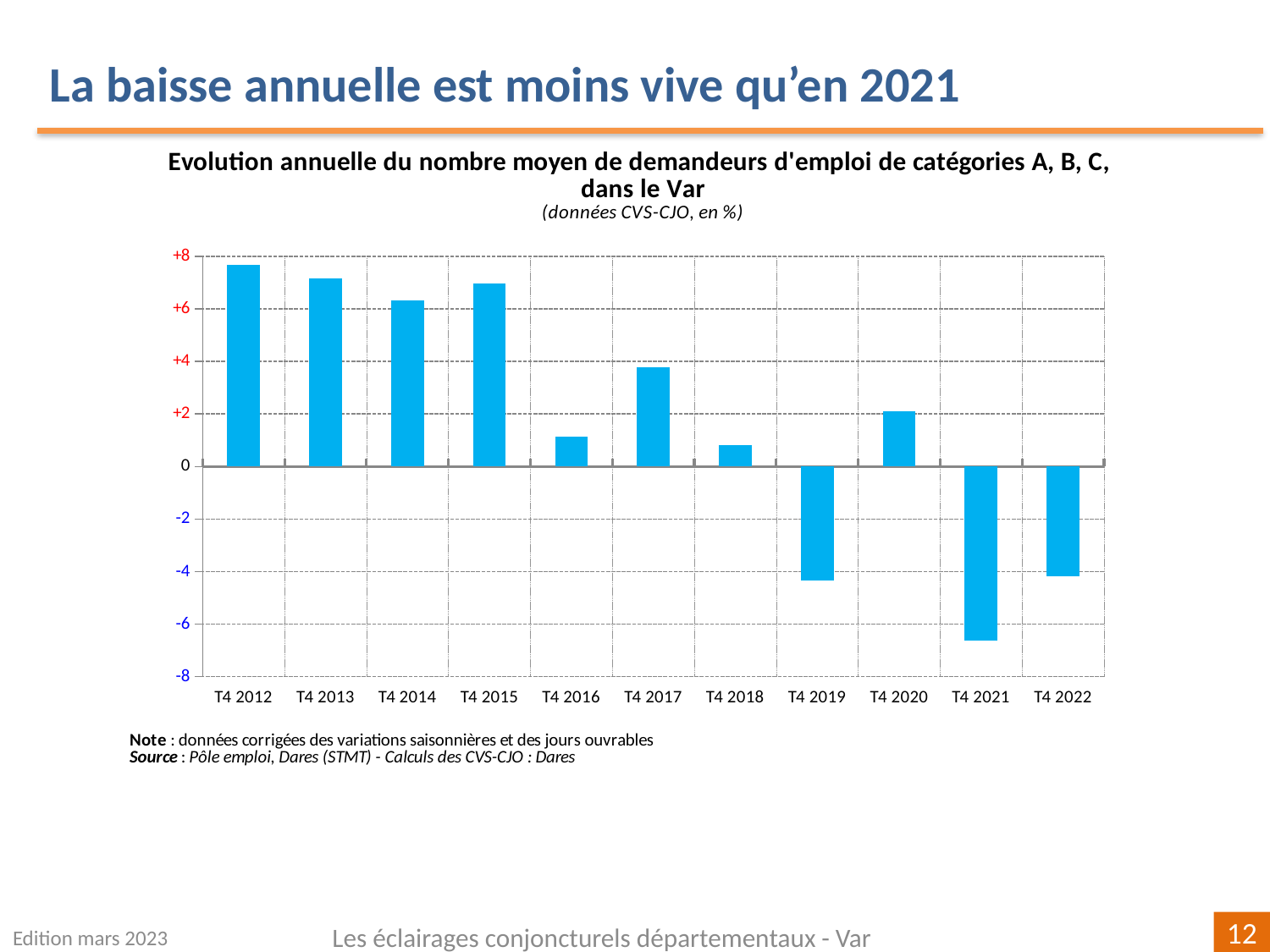
Which period has the highest value? T4 2012 Is the value for T4 2012 greater or less than +6? greater Is the value for T4 2016 greater or less than +2? less Which period has the lowest value? T4 2021 Is the value for T4 2021 greater or less than -6? less Do the values generally rise or fall from T4 2012 to T4 2022? fall What kind of chart is shown on the slide? bar chart How many periods (bars) are plotted on the x axis? 11 Which has the larger value, T4 2014 or T4 2017? T4 2014 In what unit are the data expressed, according to the chart subtitle? % How many periods show a negative value? 3